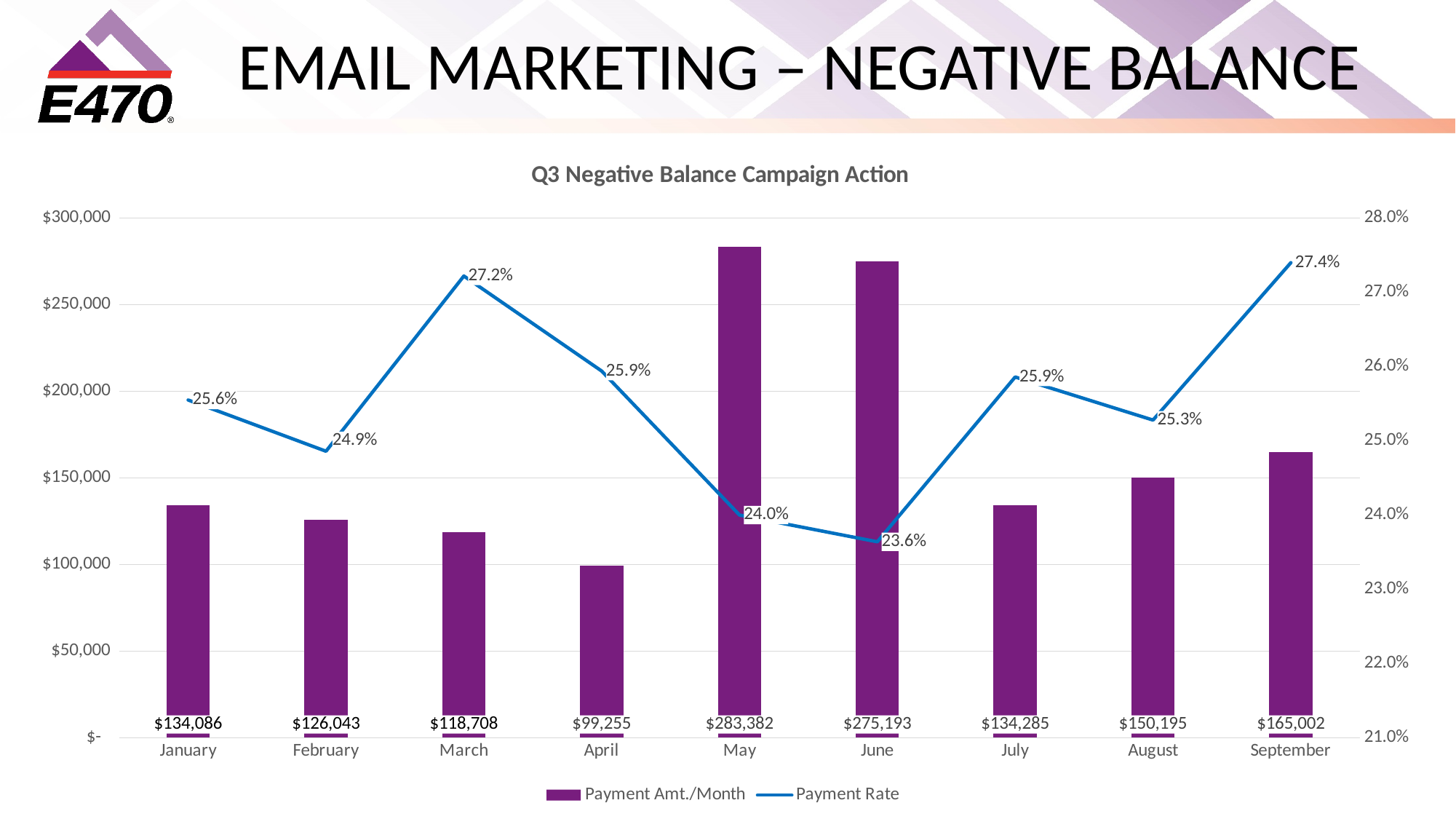
What kind of chart is shown on the slide? Combination bar and line chart Which month has the highest Payment Amt./Month? May Which month has the lowest Payment Rate? June What is the Payment Rate for September? 27.4% Which month has the lowest Payment Amt./Month? April What is the difference between the Payment Amt./Month for May and June? $8,189 Does the Payment Amt./Month rise or fall from January to April? Fall What is the Payment Amt./Month for May? $283,382 How many months are shown on the x axis? 9 What is the Payment Rate for March? 27.2% Which month has a larger Payment Amt./Month, July or August? August How many series does the legend list? 2